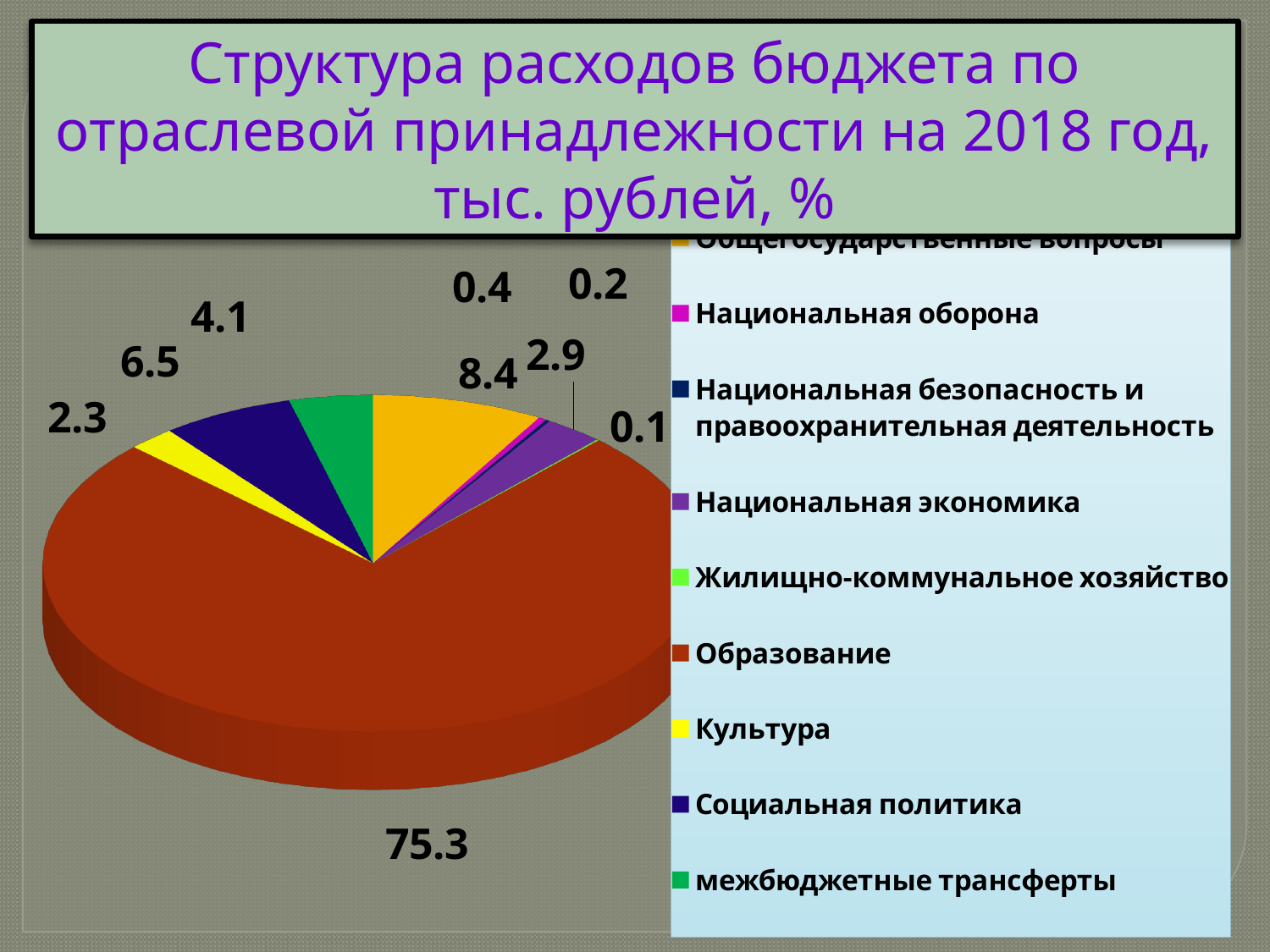
What kind of chart is shown on the slide? pie chart What is the value for Образование? 75.3 How many entries does the legend list? 9 Which category has the largest share of the pie? Образование What is the value for Культура? 2.3 What is the difference between the values for Социальная политика and межбюджетные трансферты? 2.4 What colour is the slice for Образование? red What is the value for Национальная экономика? 2.9 What is the value for Социальная политика? 6.5 What is the smallest value printed on the pie chart? 0.1 What is the value for межбюджетные трансферты? 4.1 Which is larger, Социальная политика or Культура? Социальная политика